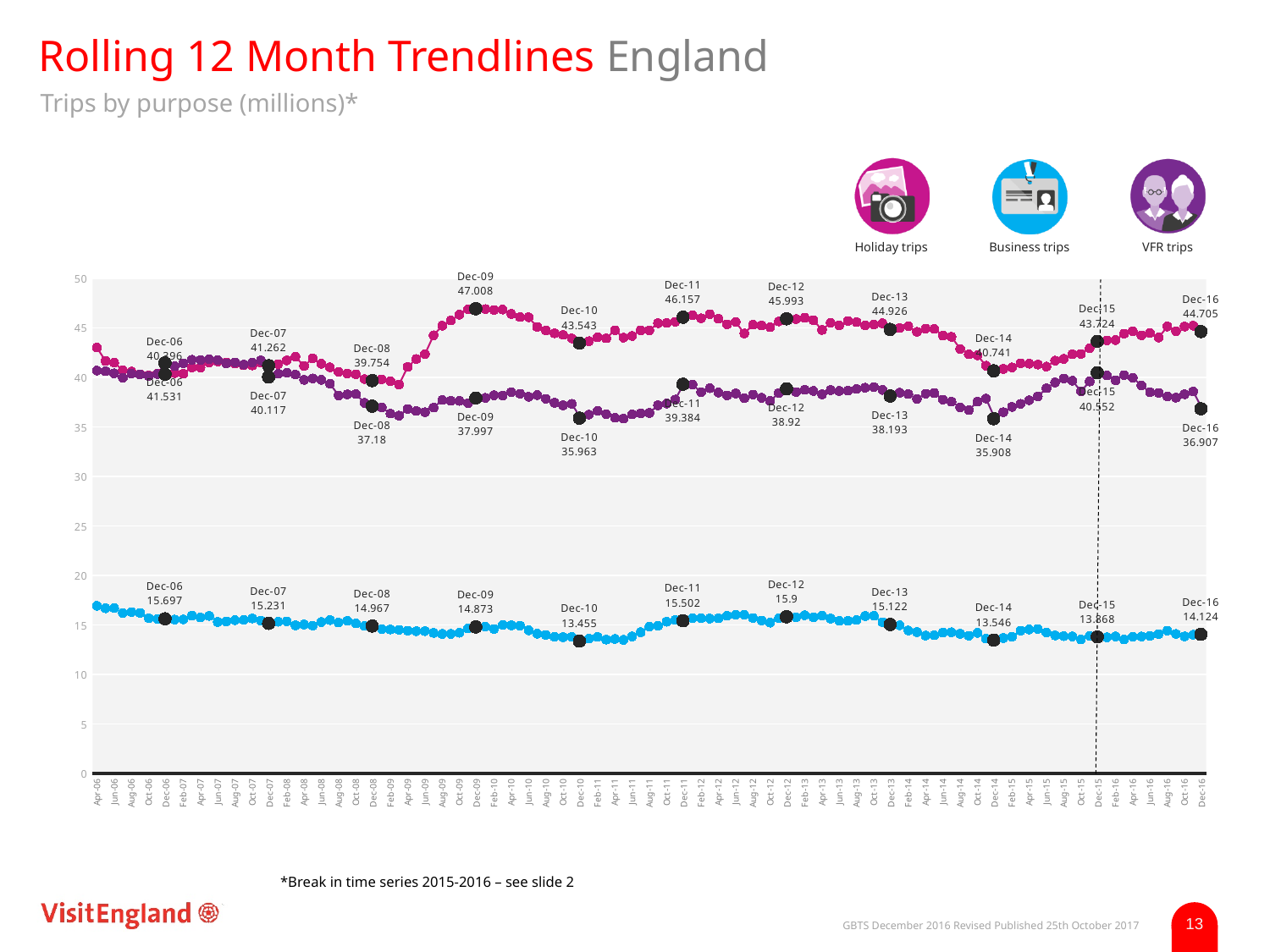
Among the labelled December points, which December has the lowest value for Business trips? Dec-10 Is the value for VFR trips at Dec-10 greater or less than 40? less Which is larger: Business trips at Dec-12 or Business trips at Dec-13? Dec-12 What is the difference between the Holiday trips values at Dec-16 and Dec-15? 0.981 Among the labelled December points, which December has the highest value for Holiday trips? Dec-09 What type of chart is shown on the slide? line chart What is the value of Business trips at Dec-16? 14.124 Did Business trips rise or fall between Dec-14 and Dec-16? rise How many series does the chart show? 3 What colour is the line for Business trips? blue What is the value of VFR trips at Dec-14? 35.908 What is the value of Holiday trips at Dec-09? 47.008